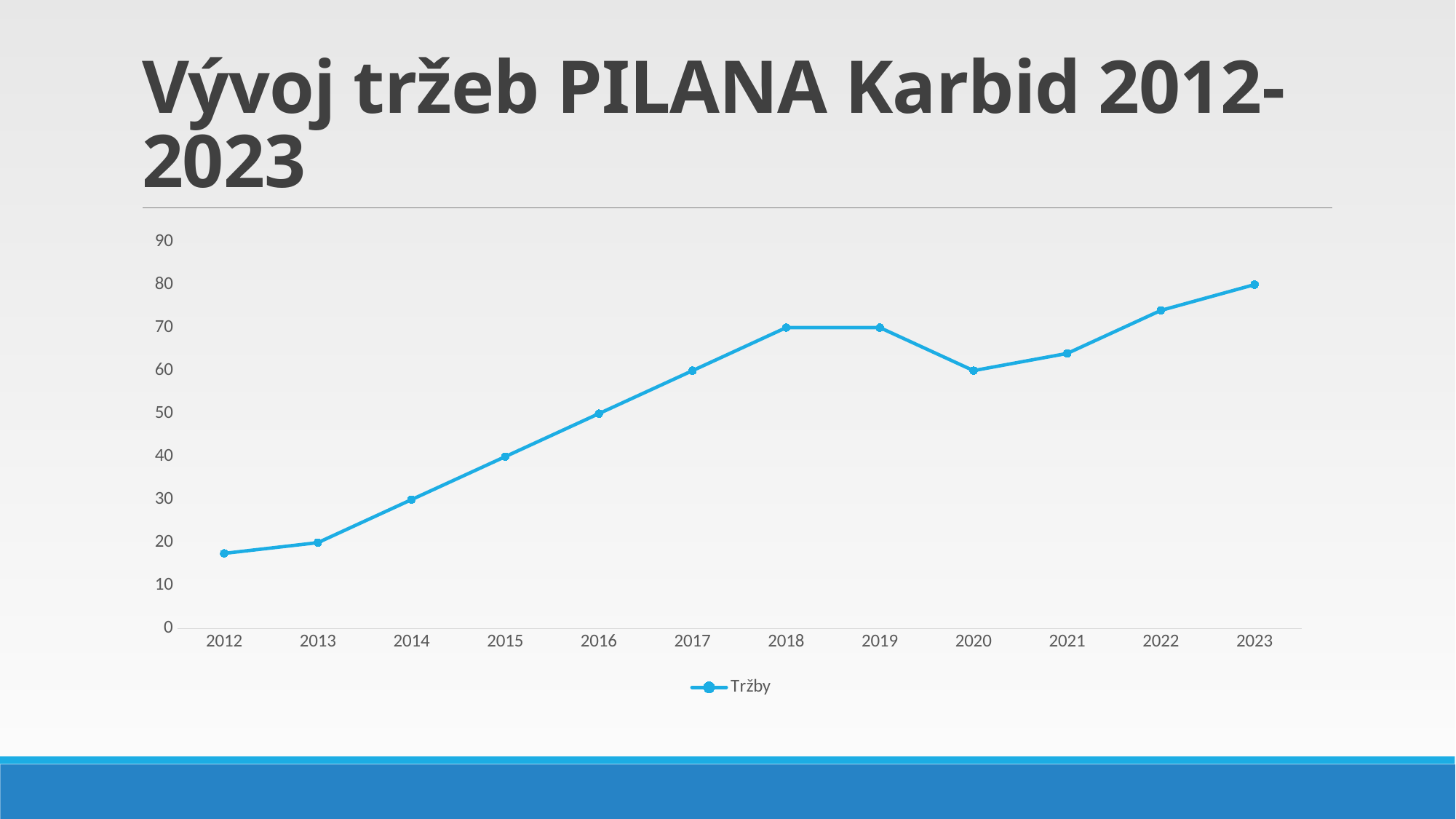
Is the value of Tržby for 2022 greater or less than 70? greater What is the value of Tržby for 2018? 70 What is the difference between the Tržby values for 2018 and 2014? 40 What is the title of the slide's chart? Vývoj tržeb PILANA Karbid 2012-2023 What is the value of Tržby for 2020? 60 How many years are plotted on the x axis? 12 Which year has the highest value of Tržby? 2023 How many series does the legend list? 1 What is the value of Tržby for 2016? 50 What type of chart is shown on the slide? line chart Which year has the lowest value of Tržby? 2012 Is the value of Tržby for 2012 greater or less than 20? less